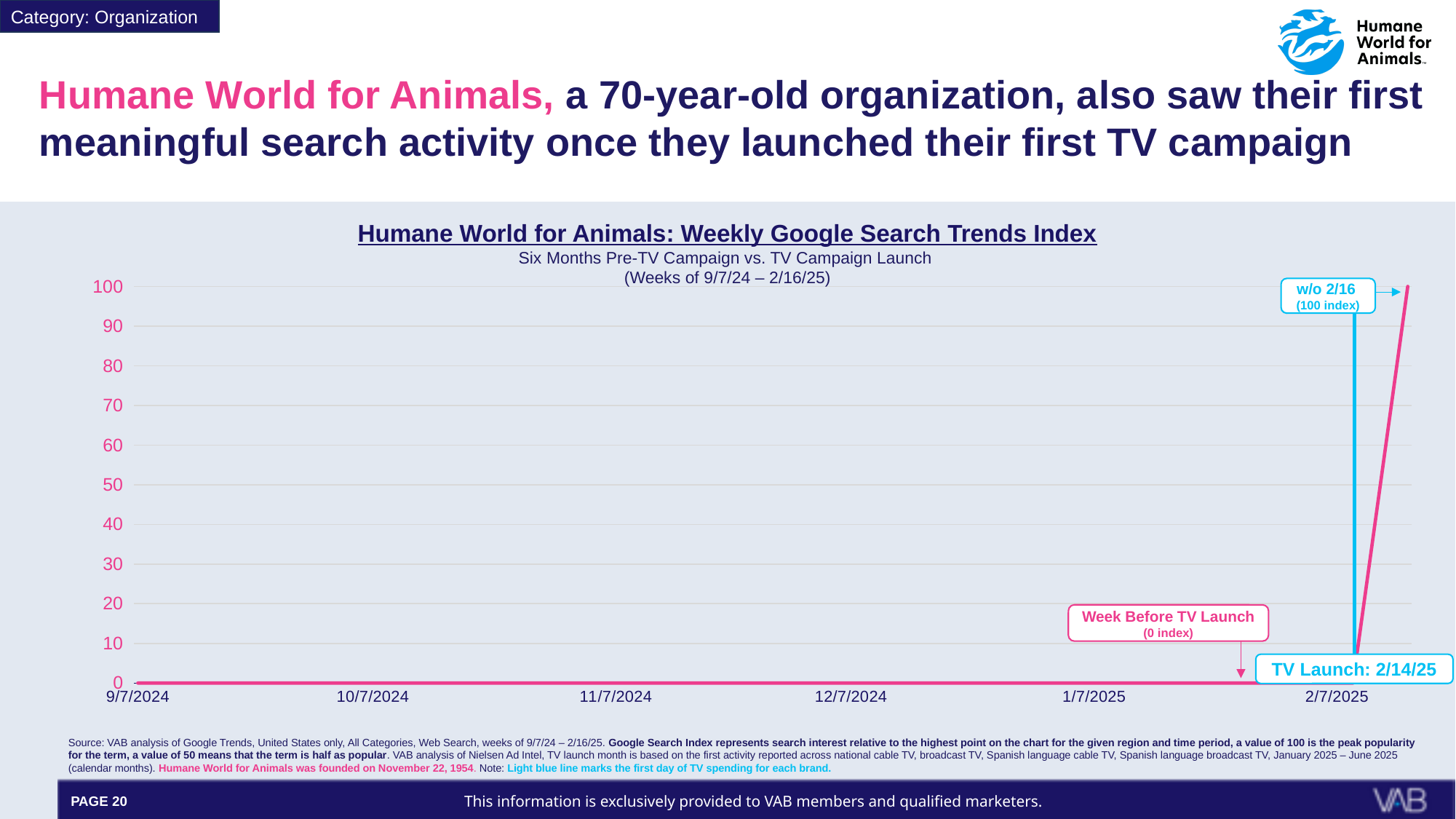
How many date labels are shown on the x axis? 6 What kind of chart is shown on the slide? line chart Which week has the highest search trends index value? w/o 2/16 What is the date of the TV launch marked on the chart? 2/14/25 Does the search trends index rise or fall at the right end of the chart after the TV launch? rise What is the search trends index value for the week before the TV launch? 0 What is the highest value shown on the y axis? 100 What is the first date label on the x axis? 9/7/2024 What is the search trends index value for the week of 2/16? 100 Which is larger, the index for the week of 2/16 or the index for the week before the TV launch? w/o 2/16 What is the difference between the index for the week of 2/16 and the week before the TV launch? 100 Is the index value for the week of 1/7/2025 greater or less than 10? less